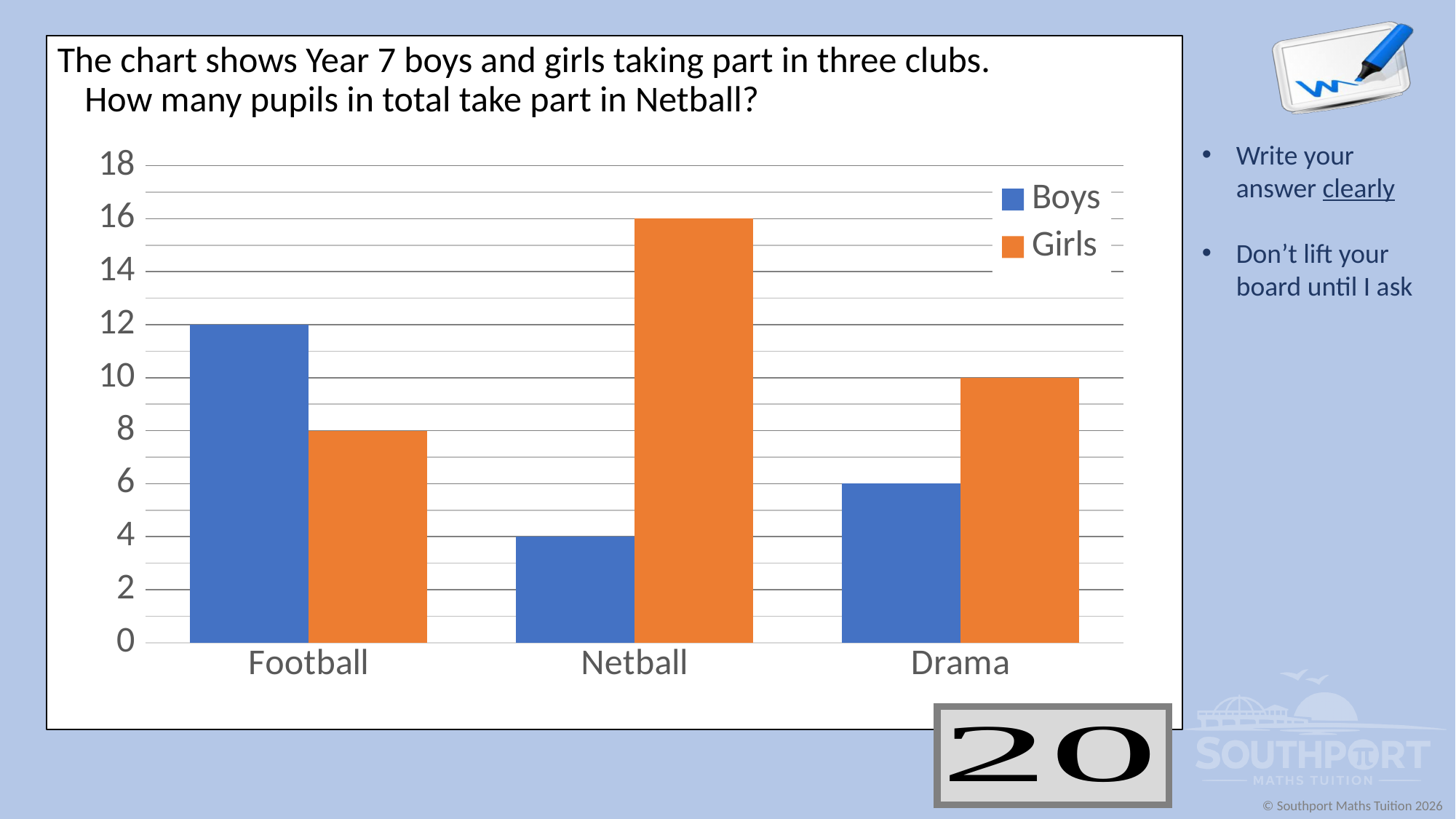
How many boys take part in Drama? 6 How many more girls than boys take part in Netball? 12 How many girls take part in Netball? 16 Which club has the most girls taking part? Netball How many pupils in total take part in Netball? 20 How many girls take part in Football? 8 What kind of chart is shown on the slide? Bar chart Are there more boys or girls taking part in Football? Boys How many series does the legend list? 2 How many boys take part in Football? 12 Which club has the fewest boys taking part? Netball How many clubs are shown on the x axis? 3